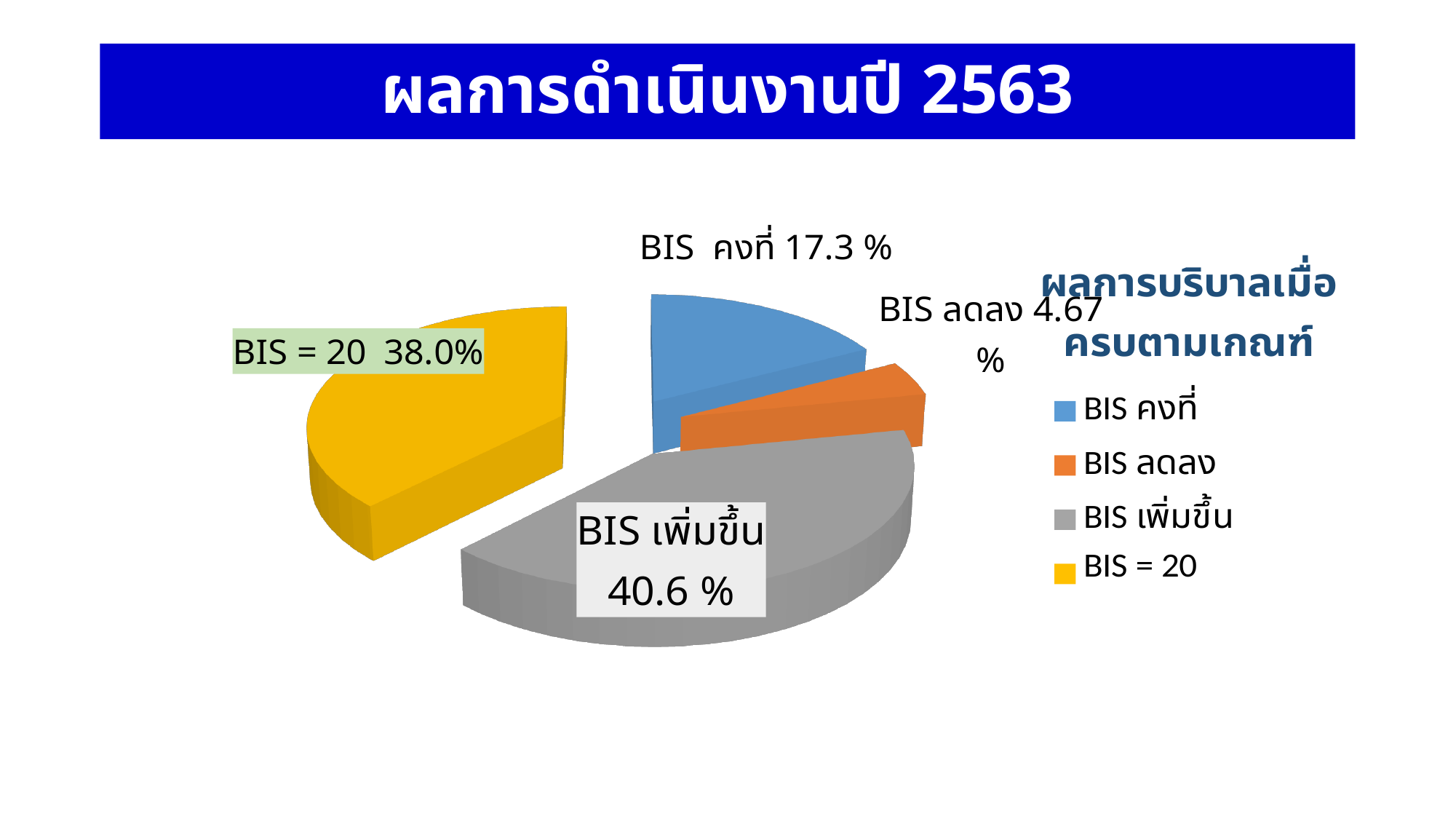
Which category has the largest share of the pie? BIS เพิ่มขึ้น What is the percentage shown for BIS = 20? 38.0% What is the title shown above the legend of the chart? ผลการบริบาลเมื่อครบตามเกณฑ์ What is the difference in percentage points between BIS เพิ่มขึ้น and BIS = 20? 2.6 What is the percentage shown for BIS ลดลง? 4.67 % What is the percentage shown for BIS เพิ่มขึ้น? 40.6 % What kind of chart is shown on the slide? pie chart What is the percentage shown for BIS คงที่? 17.3 % Which is larger, the share for BIS คงที่ or the share for BIS = 20? BIS = 20 Which category has the smallest share of the pie? BIS ลดลง Which colour represents BIS = 20 in the legend? yellow How many slices does the pie chart have? 4